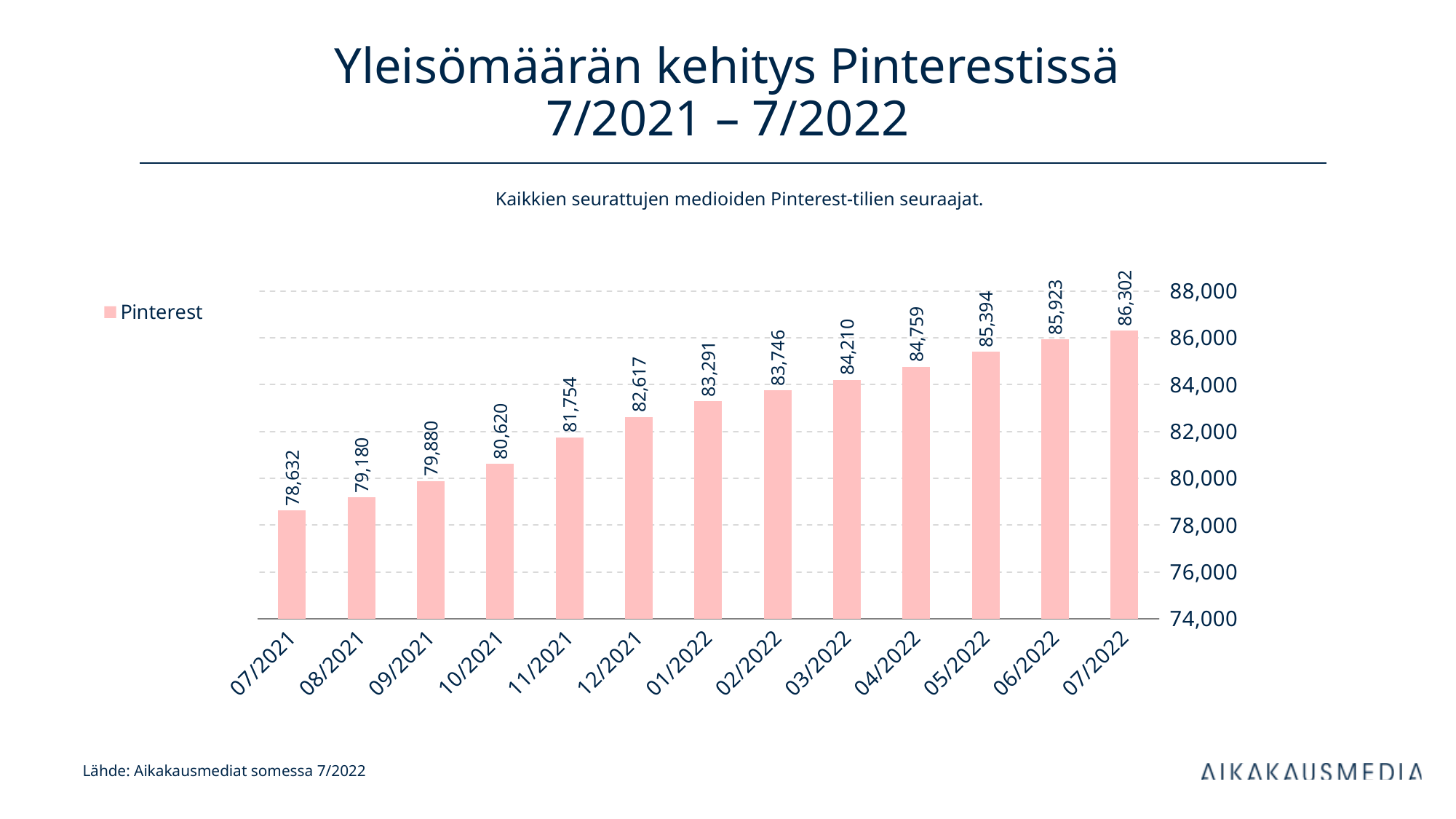
Is the value for 05/2022 greater or less than 84,000? greater Do the values rise or fall from 07/2021 to 07/2022? rise What kind of chart is shown? bar chart What is the value for 07/2022? 86,302 What is the value for 01/2022? 83,291 What is the difference between the values for 12/2021 and 11/2021? 863 How many months are shown on the x axis? 13 Which month has the highest value? 07/2022 Which month has the lowest value? 07/2021 What is the difference between the values for 07/2022 and 07/2021? 7,670 What is the value for 07/2021? 78,632 Which is larger, the value for 03/2022 or the value for 10/2021? 03/2022